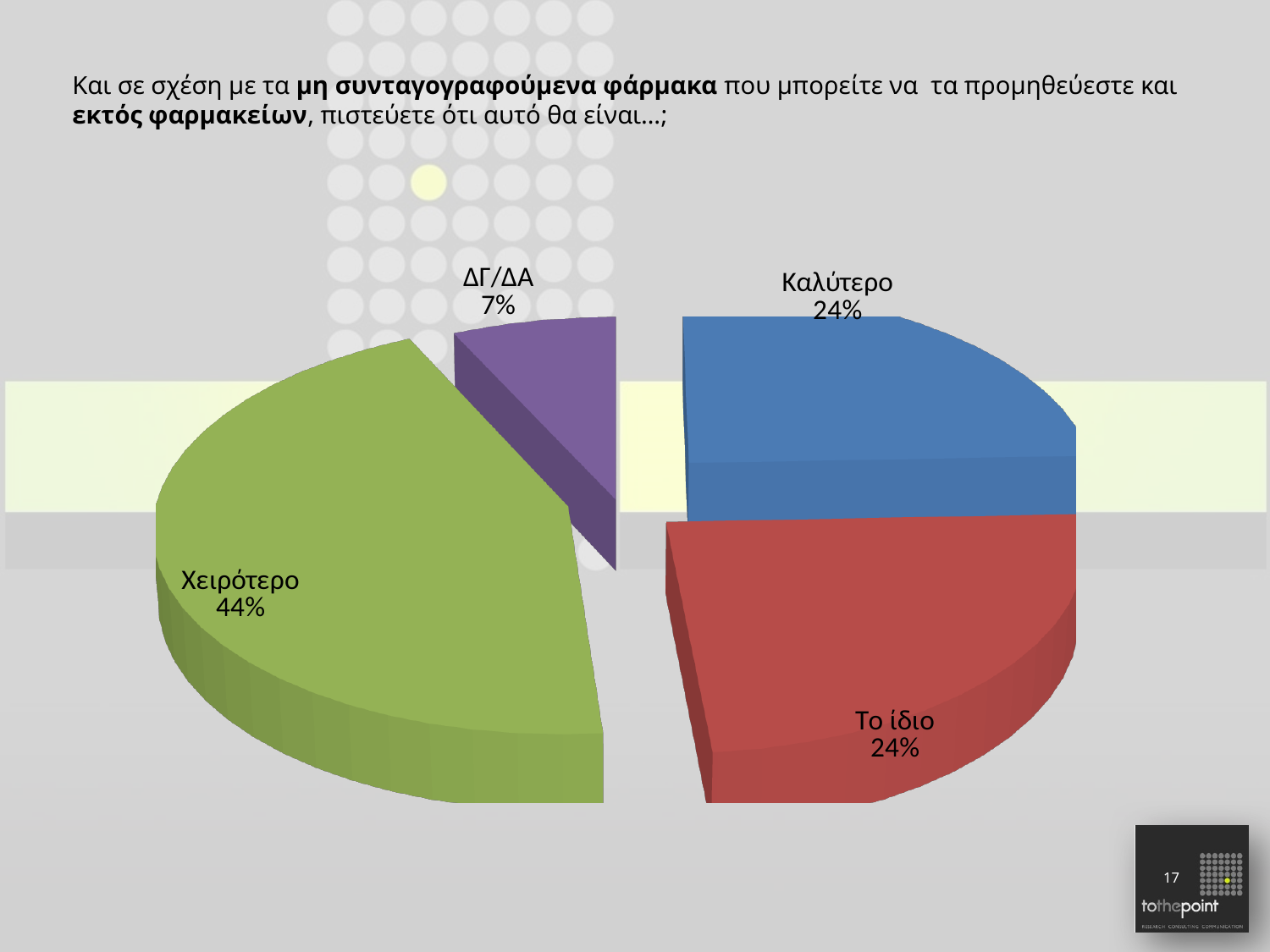
Which category has the largest share of the pie? Χειρότερο How many slices does the pie chart have? 4 What percentage of respondents answered Καλύτερο? 24% What colour is the slice for Καλύτερο? Blue Which is larger, the share for Χειρότερο or the share for ΔΓ/ΔΑ? Χειρότερο What is the difference in percentage points between Χειρότερο and Καλύτερο? 20 What percentage of respondents answered Χειρότερο? 44% What kind of chart is shown on the slide? Pie chart Which category has the smallest share of the pie? ΔΓ/ΔΑ What colour is the slice for Χειρότερο? Green What percentage of respondents answered ΔΓ/ΔΑ? 7% What percentage of respondents answered Το ίδιο? 24%